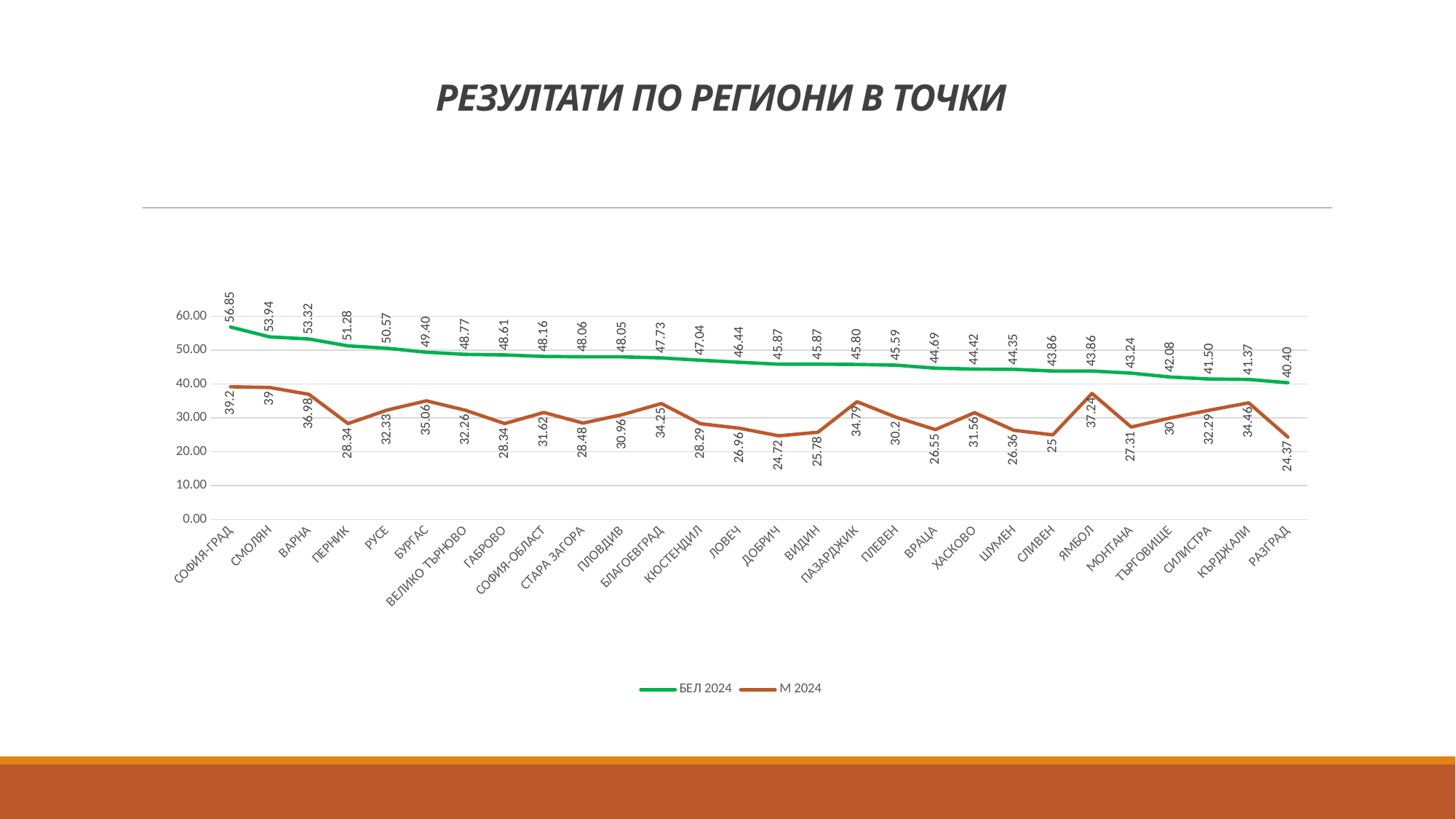
Which region has the lowest М 2024 value? РАЗГРАД What is the difference between the БЕЛ 2024 and М 2024 values for ДОБРИЧ? 21.15 What kind of chart is shown on the slide? line chart What is the title of the chart? РЕЗУЛТАТИ ПО РЕГИОНИ В ТОЧКИ How many series does the legend list? 2 What is the БЕЛ 2024 value for ПЕРНИК? 51.28 Does the БЕЛ 2024 series rise or fall from left to right along the x axis? fall What is the М 2024 value for ЯМБОЛ? 37.24 Which colour is used for the М 2024 series? orange Which is larger, the М 2024 value for ПАЗАРДЖИК or for ПЛЕВЕН? ПАЗАРДЖИК How many regions are plotted along the x axis? 28 Which region has the highest БЕЛ 2024 value? СОФИЯ-ГРАД